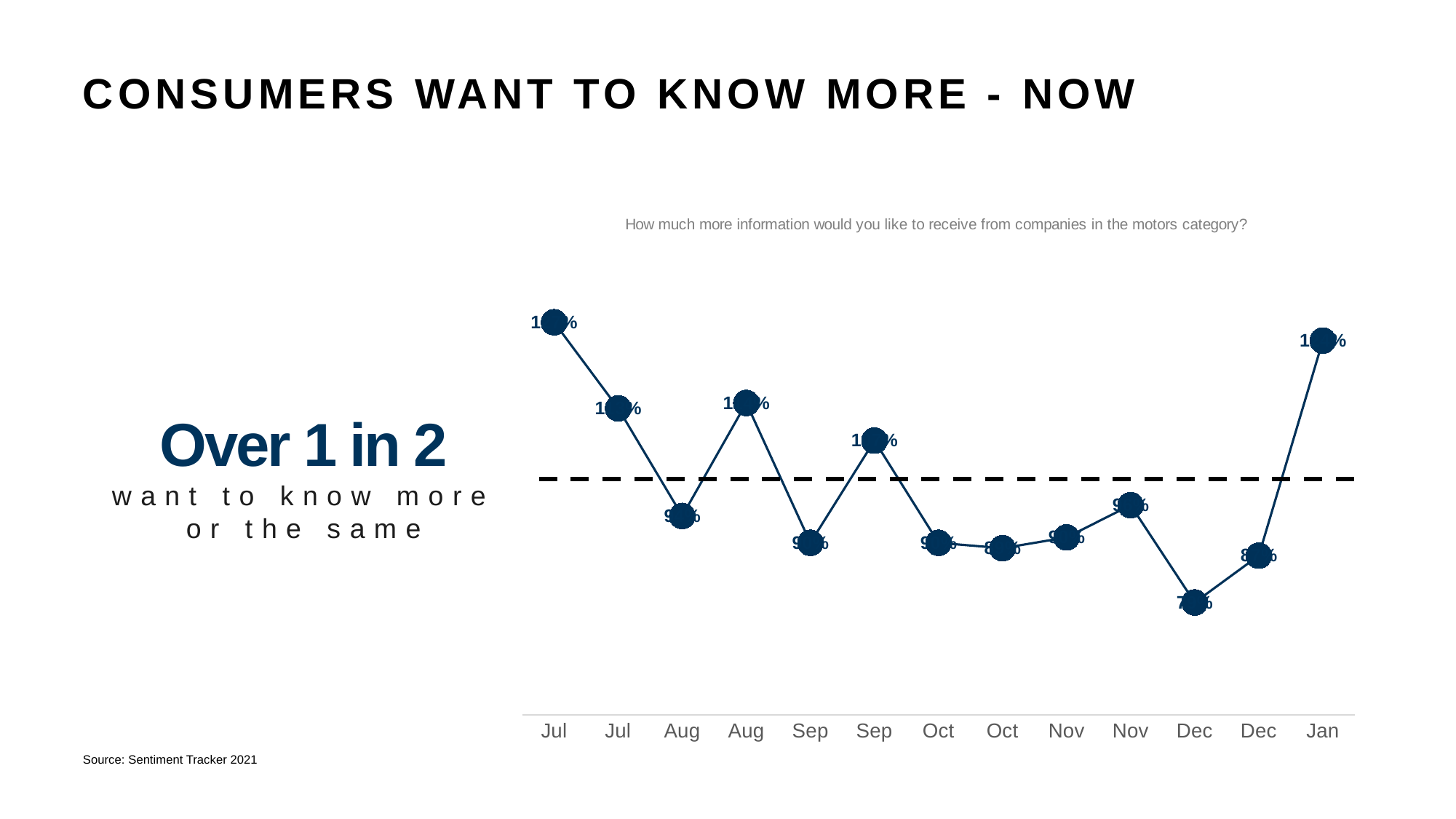
Is the value for the first Aug point larger or smaller than the value for the second Aug point? smaller Which month has the highest value on the line chart? Jul (first) Does the line rise or fall from the first Jul point to the first Aug point? fall Is the value for the first Dec point larger or smaller than the value for the second Dec point? smaller Does the line rise or fall from the second Dec point to the Jan point? rise Which month has the lowest value on the line chart? Dec (first) What kind of chart is shown on the slide? line chart How many data points are plotted on the line chart? 13 What survey question is shown above the chart? How much more information would you like to receive from companies in the motors category? What source is cited for the chart? Sentiment Tracker 2021